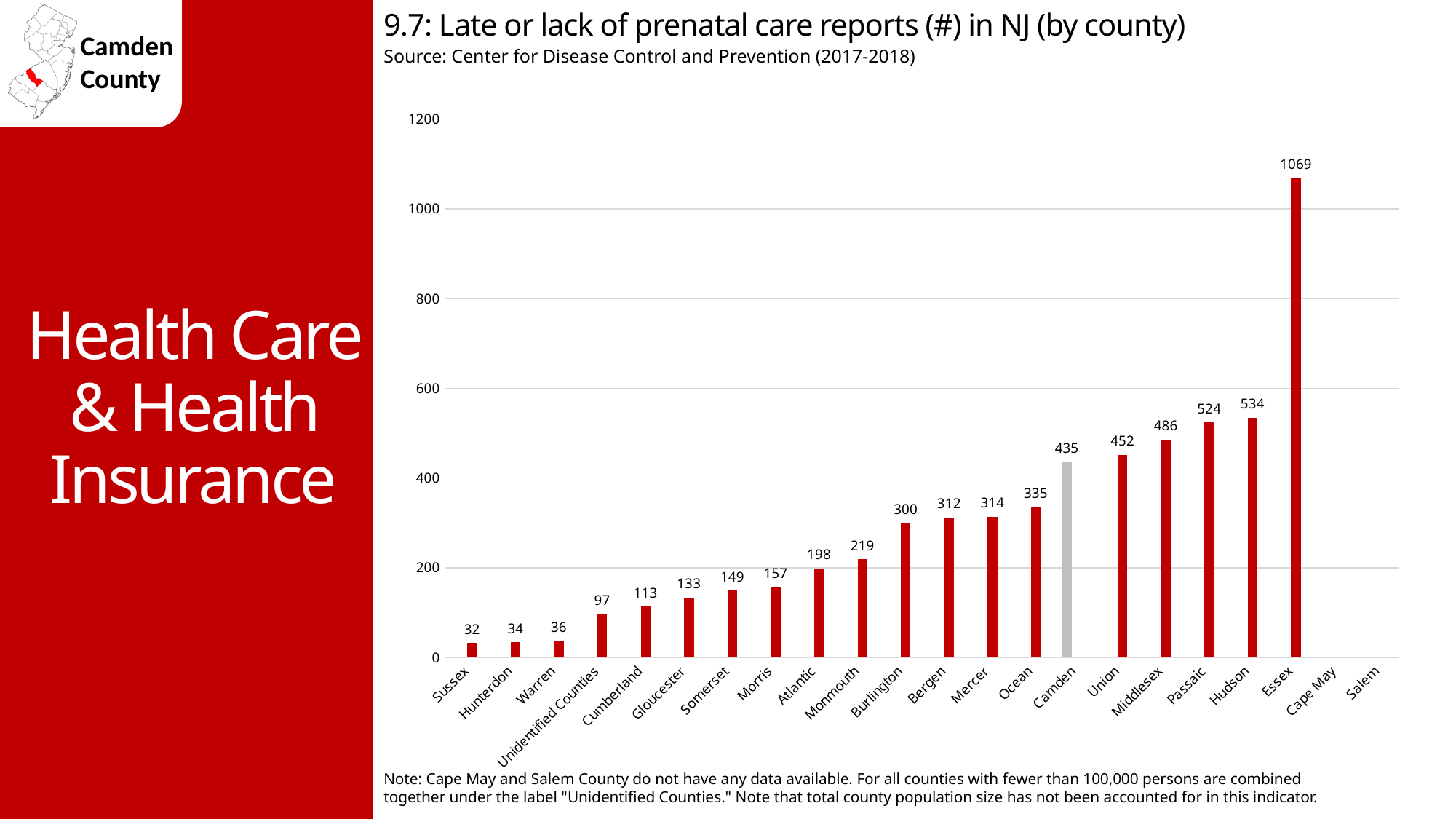
Which county has a higher value, Union or Ocean? Union What is the difference between the values for Hudson and Passaic? 10 What is the value shown for Unidentified Counties? 97 Which county has the highest number of late or lack of prenatal care reports? Essex What is the number of late or lack of prenatal care reports for Camden County? 435 How many categories are listed along the x axis? 22 What is the value shown for Essex County? 1069 Is the value for Burlington greater or less than 400? less Which county has the lowest number of reports among those with data shown? Sussex Which bar is coloured grey instead of red? Camden What kind of chart is shown on the slide? bar chart Do the values generally rise or fall from left to right along the x axis? rise